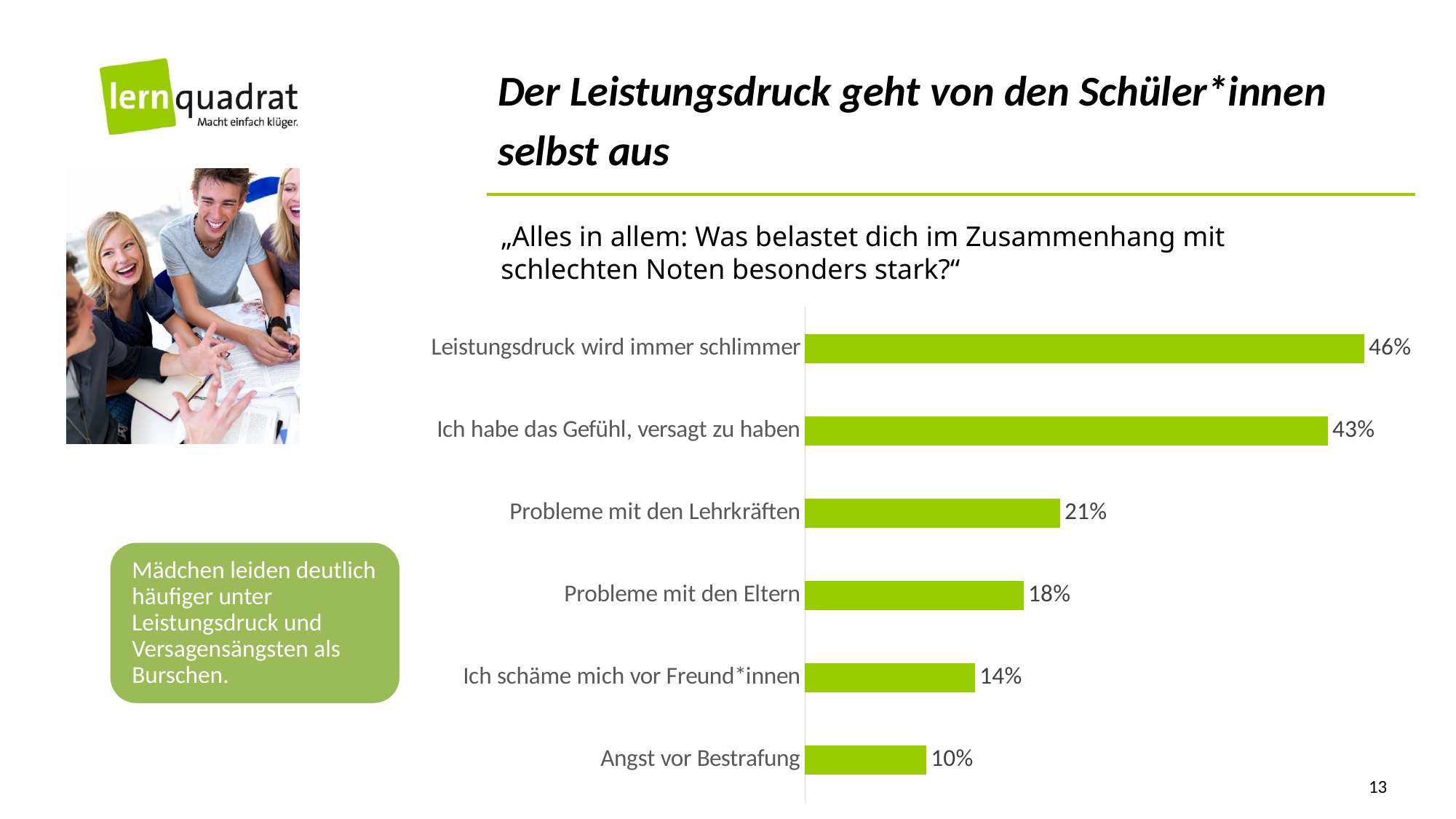
How many categories are shown in the chart? 6 Which category has the highest value? Leistungsdruck wird immer schlimmer What question is the chart based on, as stated above it? „Alles in allem: Was belastet dich im Zusammenhang mit schlechten Noten besonders stark?“ What is the value for "Probleme mit den Lehrkräften"? 21% What is the difference between "Probleme mit den Lehrkräften" and "Probleme mit den Eltern"? 3% What is the value for "Leistungsdruck wird immer schlimmer"? 46% What kind of chart is shown on the slide? Bar chart What is the value for "Ich schäme mich vor Freund*innen"? 14% What is the difference between "Leistungsdruck wird immer schlimmer" and "Ich habe das Gefühl, versagt zu haben"? 3% What is the value for "Angst vor Bestrafung"? 10% Which is larger: "Probleme mit den Eltern" or "Ich schäme mich vor Freund*innen"? Probleme mit den Eltern Which category has the lowest value? Angst vor Bestrafung